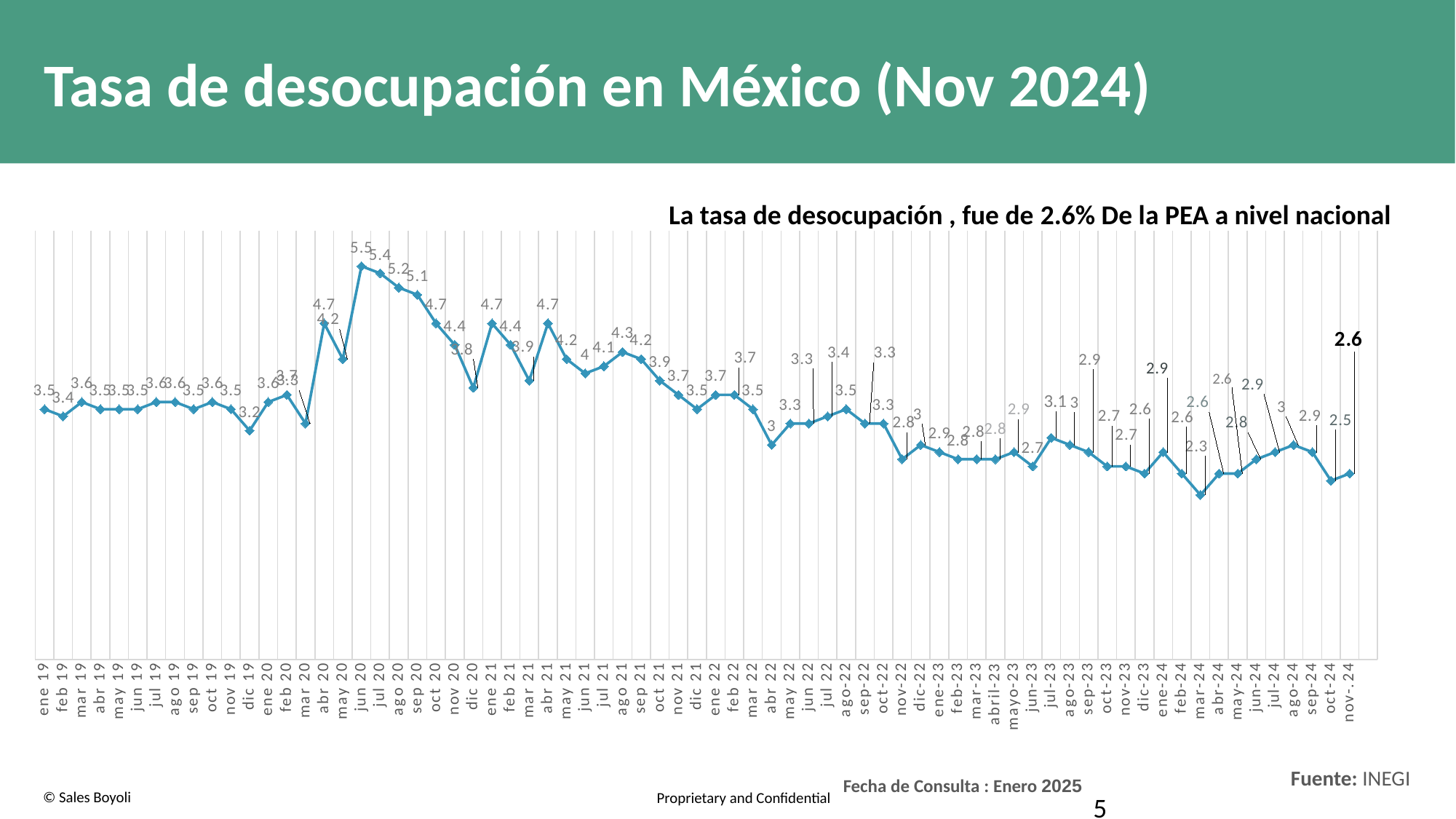
What kind of chart is shown on the slide? line chart What is the value for jun 20? 5.5 What is the value for mar-24? 2.3 Which is larger, the value for abr 20 or the value for nov-24? abr 20 What is the title of the slide? Tasa de desocupación en México (Nov 2024) Which month has the highest value in the chart? jun 20 What is the value for dic 19? 3.2 Which month has the lowest value in the chart? mar-24 Overall, does the value rise or fall from ene 19 to nov-24? fall What is the difference between the value for jun 20 and the value for mar-24? 3.2 What is the value for oct-24? 2.5 What is the unemployment rate value for nov-24? 2.6